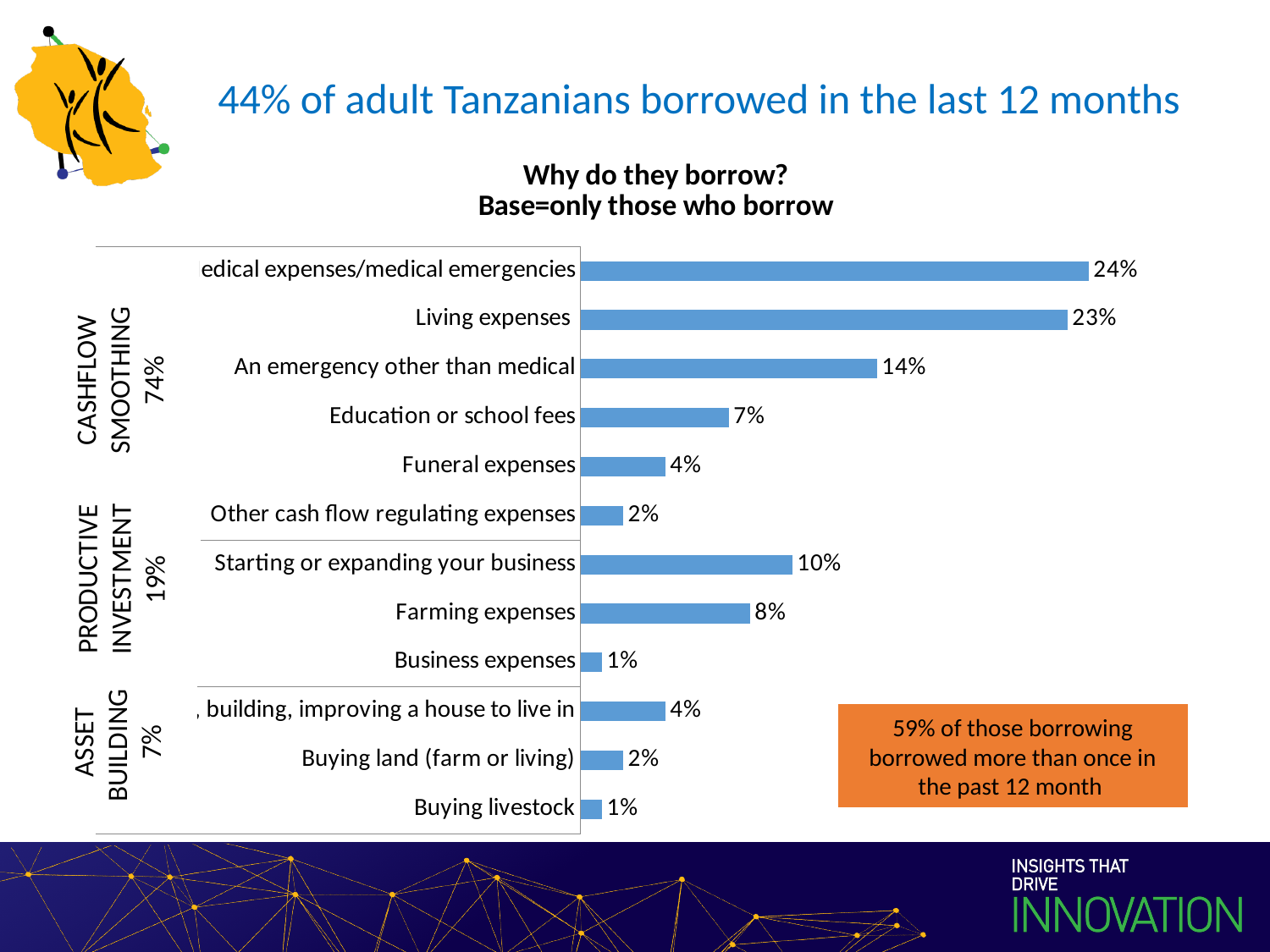
What type of chart is shown on the slide? Bar chart What percentage of borrowers borrowed for living expenses? 23% How many categories (bars) are shown on the chart? 12 What is the difference between the values for living expenses and funeral expenses? 19% What percentage borrowed for farming expenses? 8% What percentage is shown for the 'Cashflow smoothing' group? 74% What is the value for 'Buying land (farm or living)'? 2% What is the value for 'Starting or expanding your business'? 10% What is the value for 'An emergency other than medical'? 14% Which has a larger value: farming expenses or education or school fees? Farming expenses What percentage borrowed for education or school fees? 7% What is the highest percentage shown on the chart? 24%